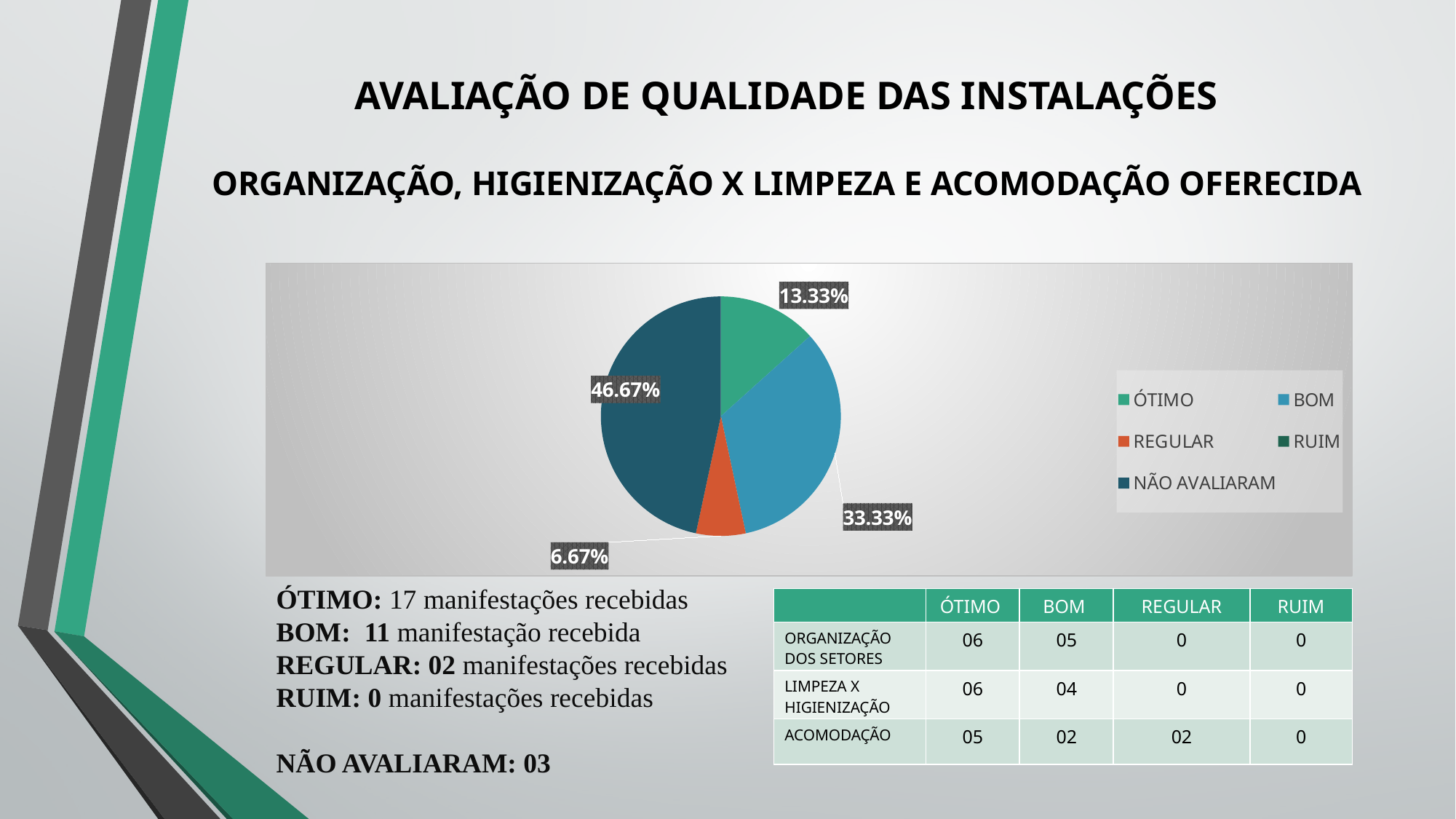
What percentage does the pie chart show for ÓTIMO? 13.33% Which slice is larger, ÓTIMO or BOM? BOM What percentage does the pie chart show for BOM? 33.33% What kind of chart is shown on the slide? pie chart How many entries does the chart legend list? 5 What percentage does the pie chart show for REGULAR? 6.67% What colour is the ÓTIMO slice in the pie chart? green What is the difference in percentage points between the NÃO AVALIARAM slice and the BOM slice? 13.34 What percentage does the pie chart show for NÃO AVALIARAM? 46.67% Which category has the largest slice of the pie chart? NÃO AVALIARAM Which legend entry has no visible slice in the pie chart? RUIM Which labelled slice of the pie chart is the smallest? REGULAR